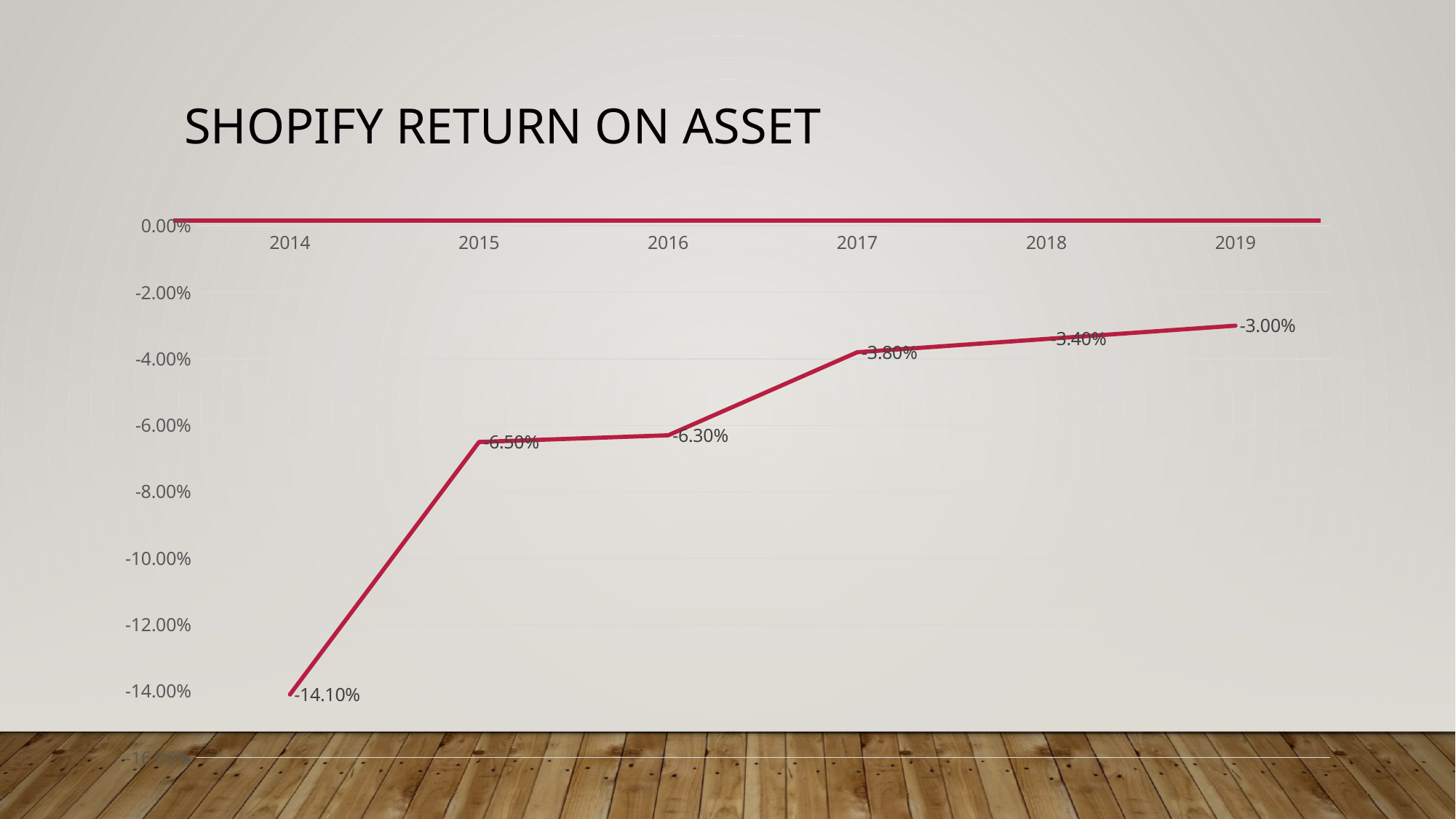
What kind of chart is shown on the slide? Line chart Does the return on asset rise or fall from 2014 to 2019? Rise Which year has a higher return on asset, 2016 or 2017? 2017 Which year has the lowest return on asset? 2014 What is the Shopify return on asset for 2019? -3.00% What is the Shopify return on asset for 2016? -6.30% What is the difference between the return on asset in 2017 and in 2019? 0.80% What is the difference between the return on asset in 2015 and in 2014? 7.60% What is the Shopify return on asset for 2014? -14.10% What is the Shopify return on asset for 2018? -3.40% Which year has the highest return on asset? 2019 How many years are plotted on the chart? 6